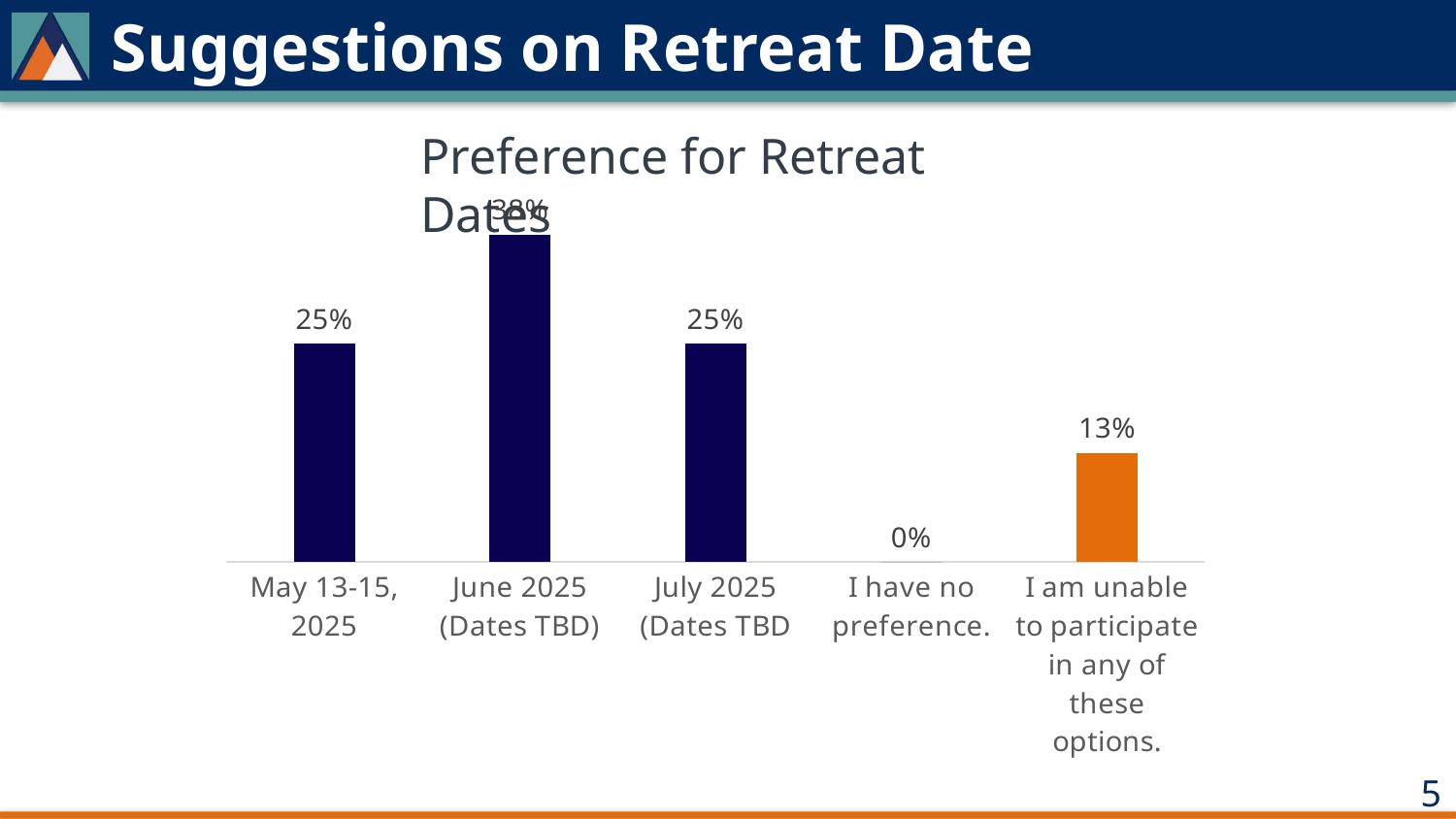
Which category has the highest value? June 2025 (Dates TBD) Which is larger: the value for May 13-15, 2025 or the value for "I am unable to participate in any of these options."? May 13-15, 2025 What is the title of the chart? Preference for Retreat Dates What kind of chart is shown on the slide? Bar chart What is the value for "I am unable to participate in any of these options."? 13% Which category has the lowest value? I have no preference. What is the value for "I have no preference."? 0% What is the difference between the value for May 13-15, 2025 and the value for "I am unable to participate in any of these options."? 12 percentage points What colour is the bar for "I am unable to participate in any of these options."? Orange What is the value for May 13-15, 2025? 25% How many categories are shown on the x axis? 5 What is the value for July 2025 (Dates TBD)? 25%